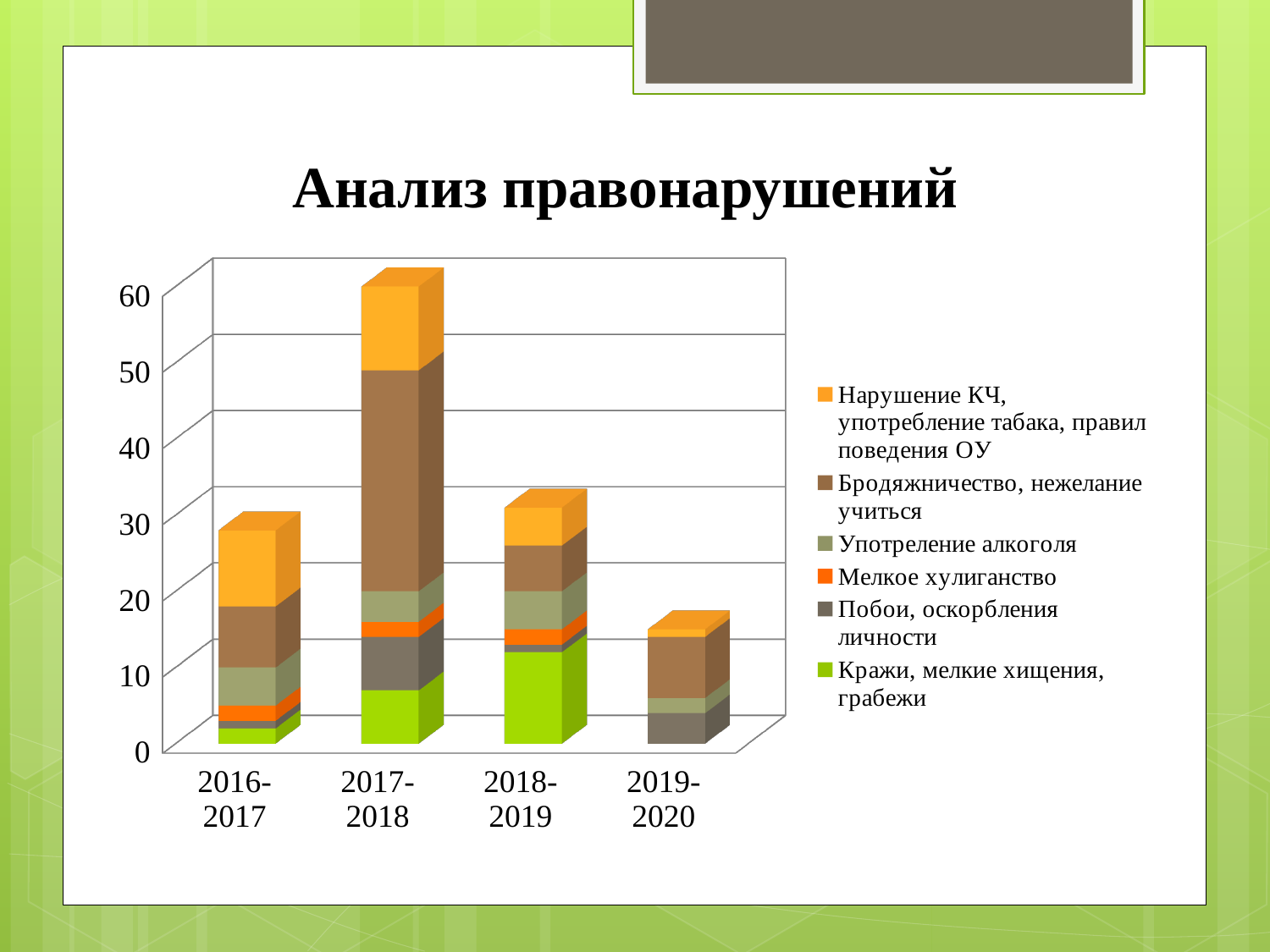
What kind of chart is shown on the slide? Stacked bar chart Which academic year has the highest total stacked bar? 2017-2018 Which total is larger, 2017-2018 or 2018-2019? 2017-2018 How many academic years (categories) are shown on the x axis? 4 Which colour represents the series "Кражи, мелкие хищения, грабежи" in the legend? Green What is the title of the chart? Анализ правонарушений Do the total values rise or fall from 2017-2018 to 2019-2020? fall How many series does the legend list? 6 Which academic year has the lowest total stacked bar? 2019-2020 Is the total for 2016-2017 greater or less than 20? greater Is the total for 2019-2020 greater or less than 20? less Is the total for 2017-2018 greater or less than 50? greater